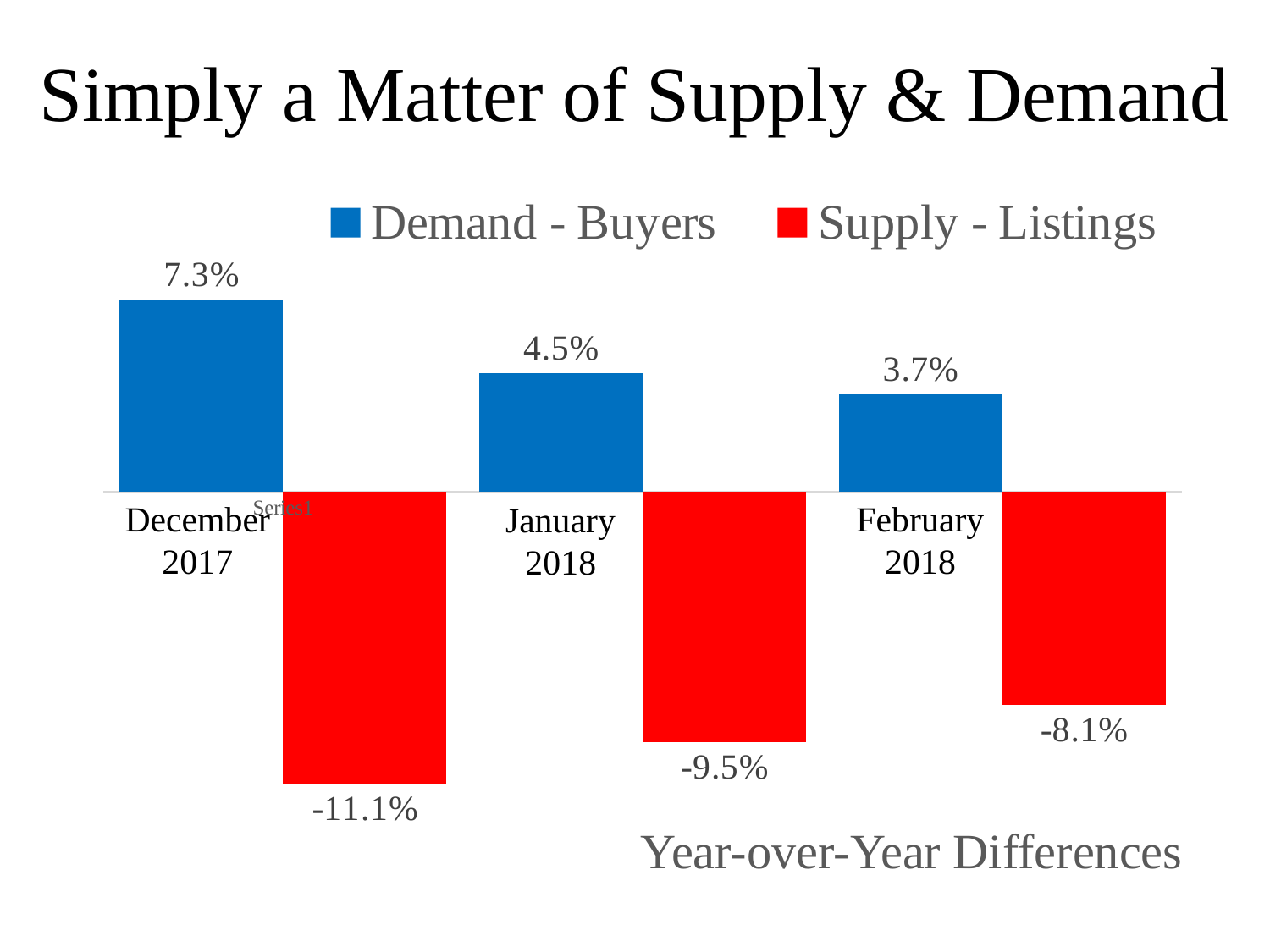
Which month has the highest Demand - Buyers value? December 2017 How many series does the legend list? 2 What is the Demand - Buyers value for December 2017? 7.3% What is the Supply - Listings value for January 2018? -9.5% What is the difference between the Demand - Buyers values for December 2017 and January 2018? 2.8% How many months are shown on the x axis? 3 Which month has the lowest Supply - Listings value? December 2017 What is the Supply - Listings value for February 2018? -8.1% What is the Demand - Buyers value for February 2018? 3.7% What kind of chart is shown on the slide? Bar chart Is the Demand - Buyers value larger for January 2018 or February 2018? January 2018 Do the Demand - Buyers values rise or fall from December 2017 to February 2018? Fall